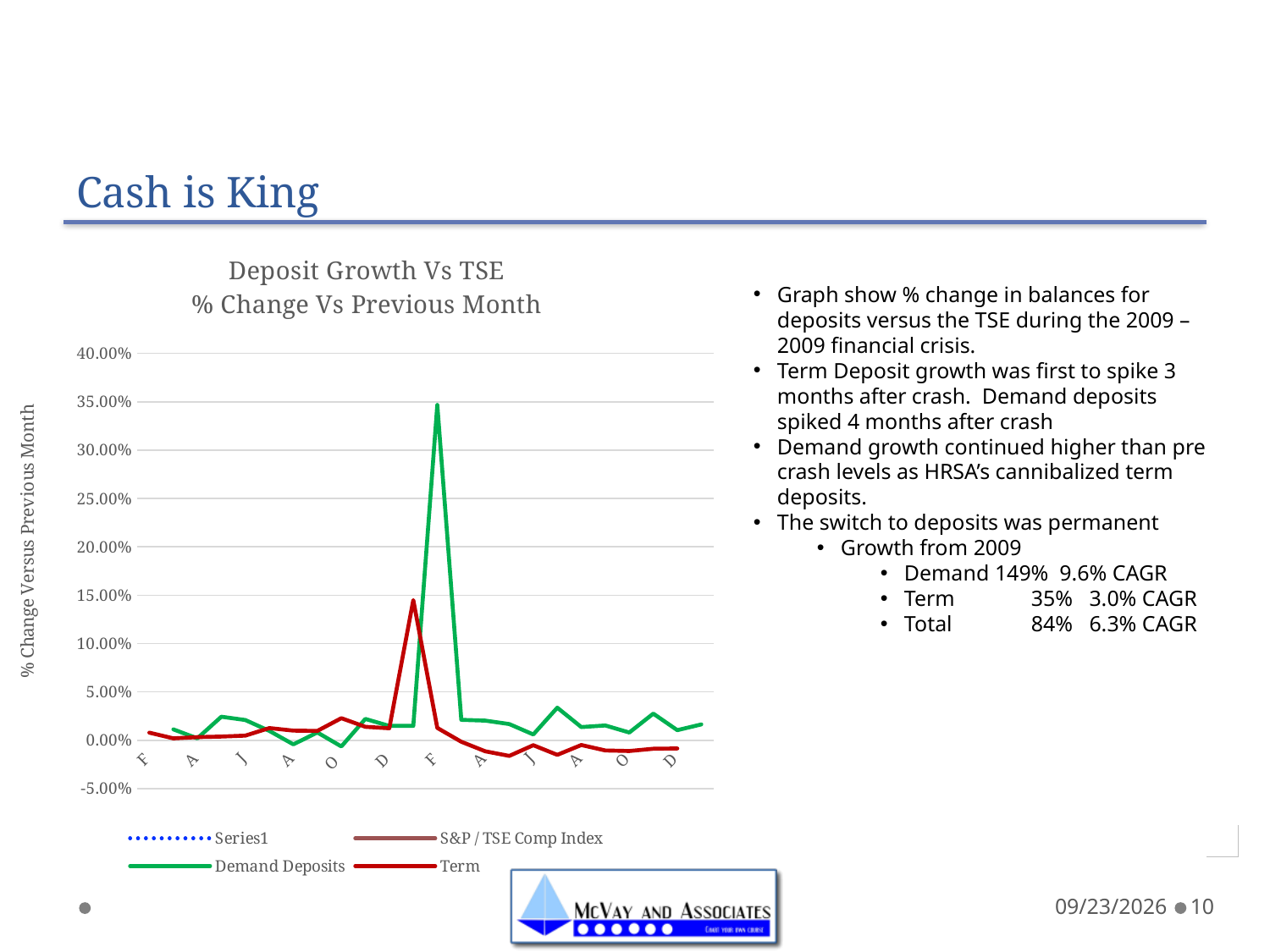
Which series reaches the higher peak, Demand Deposits or Term? Demand Deposits How many series does the chart's legend list? 4 Is the peak value of the Demand Deposits line greater or less than 40.00%? less What is the title of the chart? Deposit Growth Vs TSE % Change Vs Previous Month How many month labels are shown along the x axis of the chart? 12 What is the label on the vertical axis of the chart? % Change Versus Previous Month Is the peak value of the Term line greater or less than 10.00%? greater Is the peak value of the Term line greater or less than 15.00%? less What is the highest value shown on the vertical axis of the chart? 40.00% What kind of chart is shown on the slide? line chart